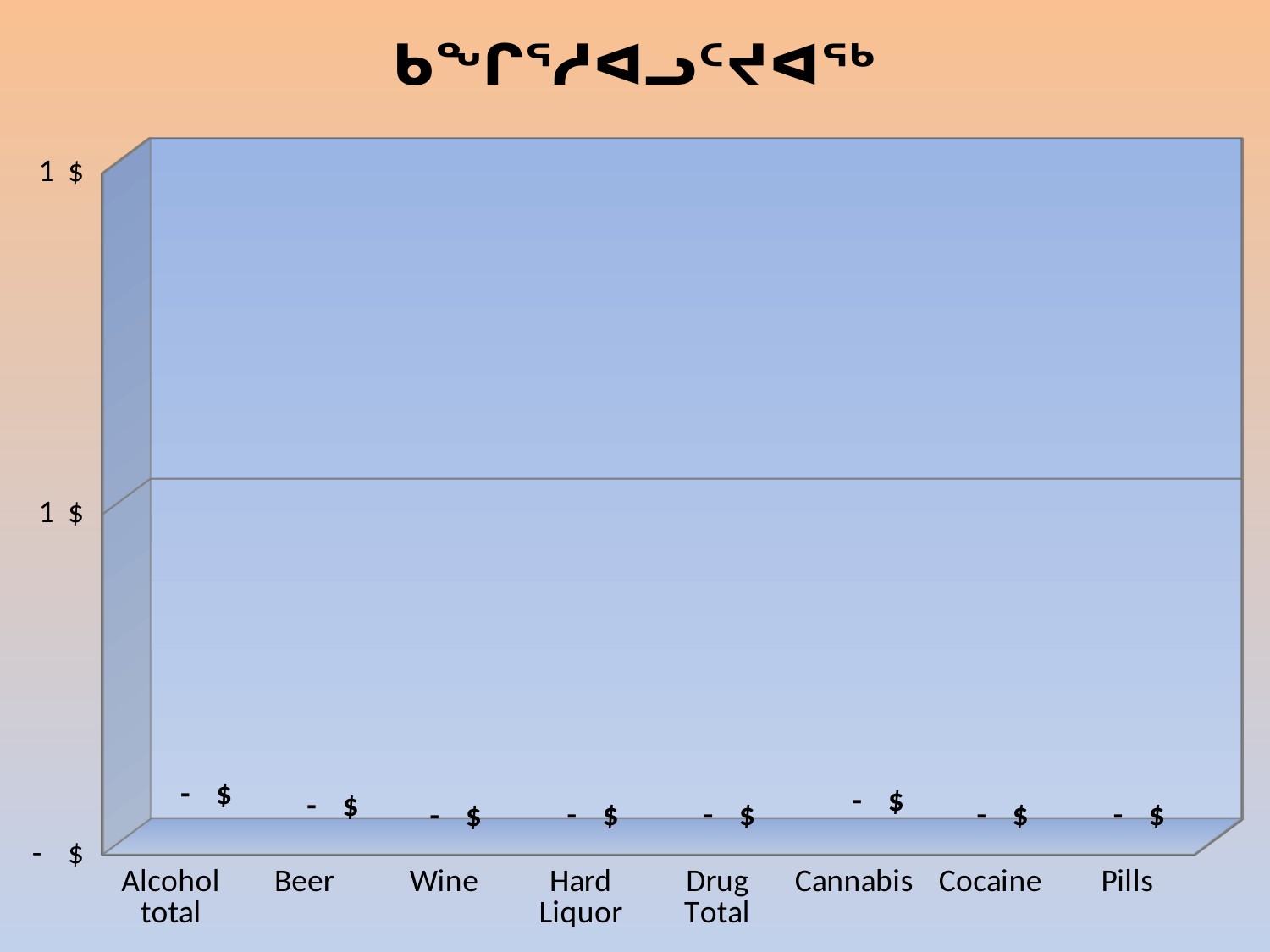
What is the last category label on the x axis? Pills How many categories are shown on the x axis of the chart? 8 What value is printed as the data label for Drug Total? - $ What value is printed as the data label for Cannabis? - $ Do the data labels show any category with a value above - $? No Is the value for Cocaine greater or less than 1 $? less Is the value for Beer greater or less than 1 $? less What is the first category label on the x axis? Alcohol total What value is printed as the data label for Alcohol total? - $ What kind of chart is shown on the slide? bar chart What value is printed as the data label for Pills? - $